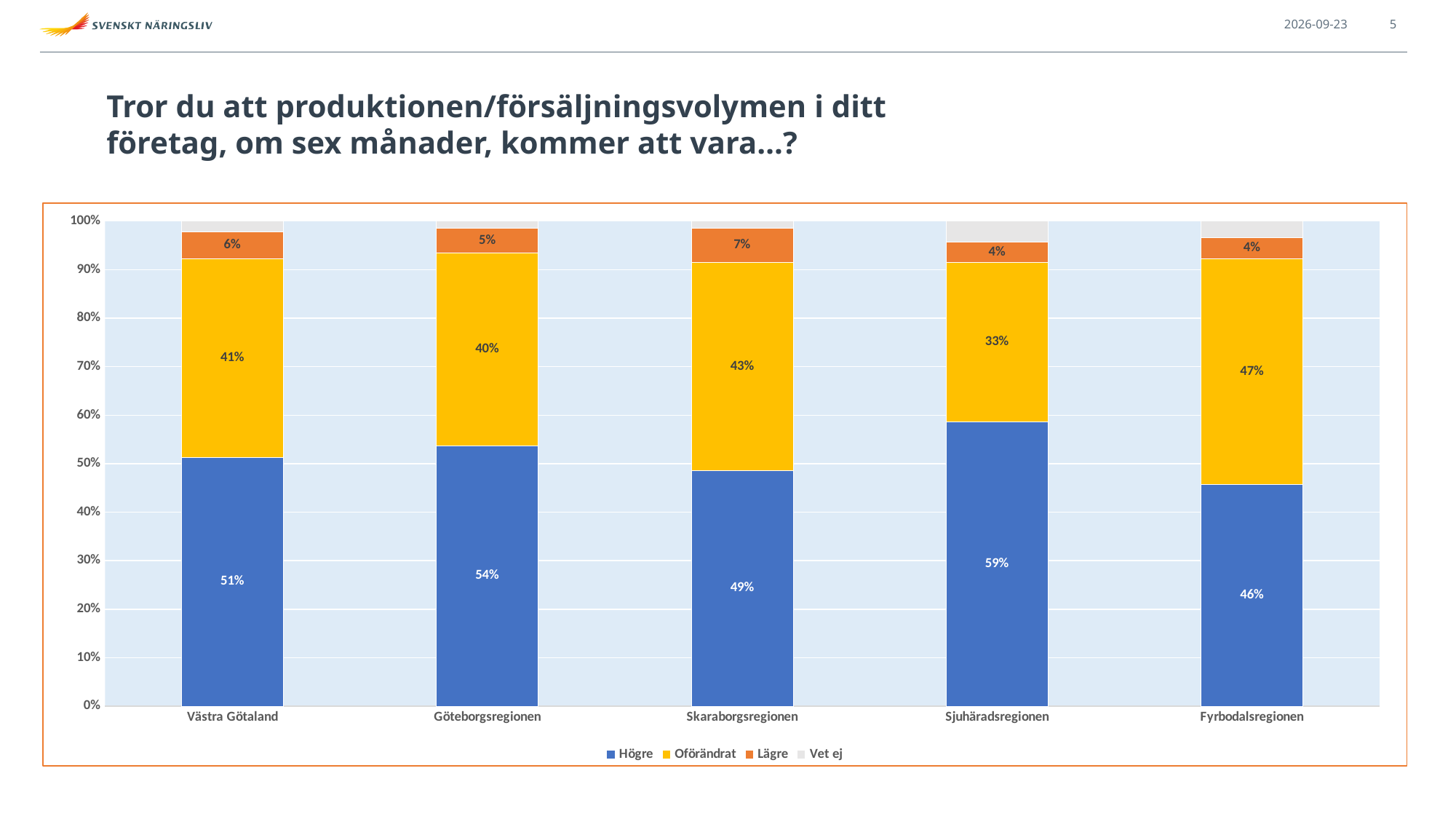
What is the difference in percentage points between the Högre share in Sjuhäradsregionen and in Fyrbodalsregionen? 13 percentage points Which is larger: the Högre share in Västra Götaland or in Skaraborgsregionen? Västra Götaland How many series does the legend list? 4 What percentage of respondents in Göteborgsregionen answered Högre? 54% Which region has the highest Högre share? Sjuhäradsregionen Is the Högre value for Fyrbodalsregionen greater or less than 50%? less Which region has the highest Lägre share? Skaraborgsregionen Which region has the lowest Oförändrat share? Sjuhäradsregionen What kind of chart is shown on the slide? Stacked bar chart What is the Lägre value for Västra Götaland? 6% How many regions are shown on the x axis? 5 What is the Oförändrat value for Skaraborgsregionen? 43%